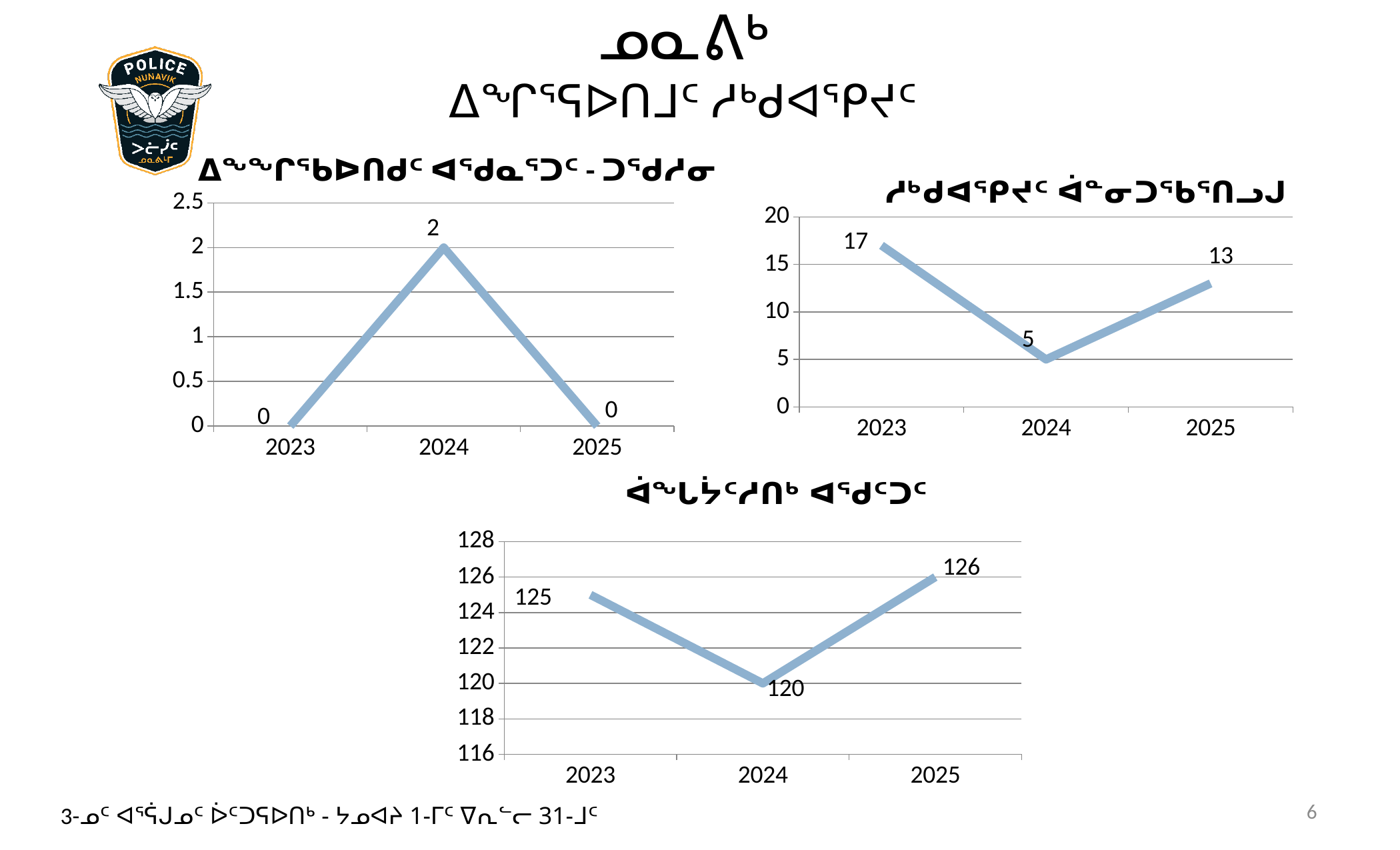
What kind of chart is the bottom chart? line chart How many data points are plotted in the top-right chart? 3 In the top-right chart, which year has the lowest value? 2024 In the bottom chart, is the value for 2024 larger or smaller than the value for 2023? smaller In the bottom chart, which year has the highest value? 2025 In the top-right chart, what is the difference between the values for 2023 and 2025? 4 In the top-right chart, what is the value for 2023? 17 In the bottom chart, what is the value for 2025? 126 In the top-right chart, what is the value for 2024? 5 In the top-left chart, what is the value for 2023? 0 In the top-left chart, what is the value for 2024? 2 In the bottom chart, what is the difference between the values for 2023 and 2024? 5